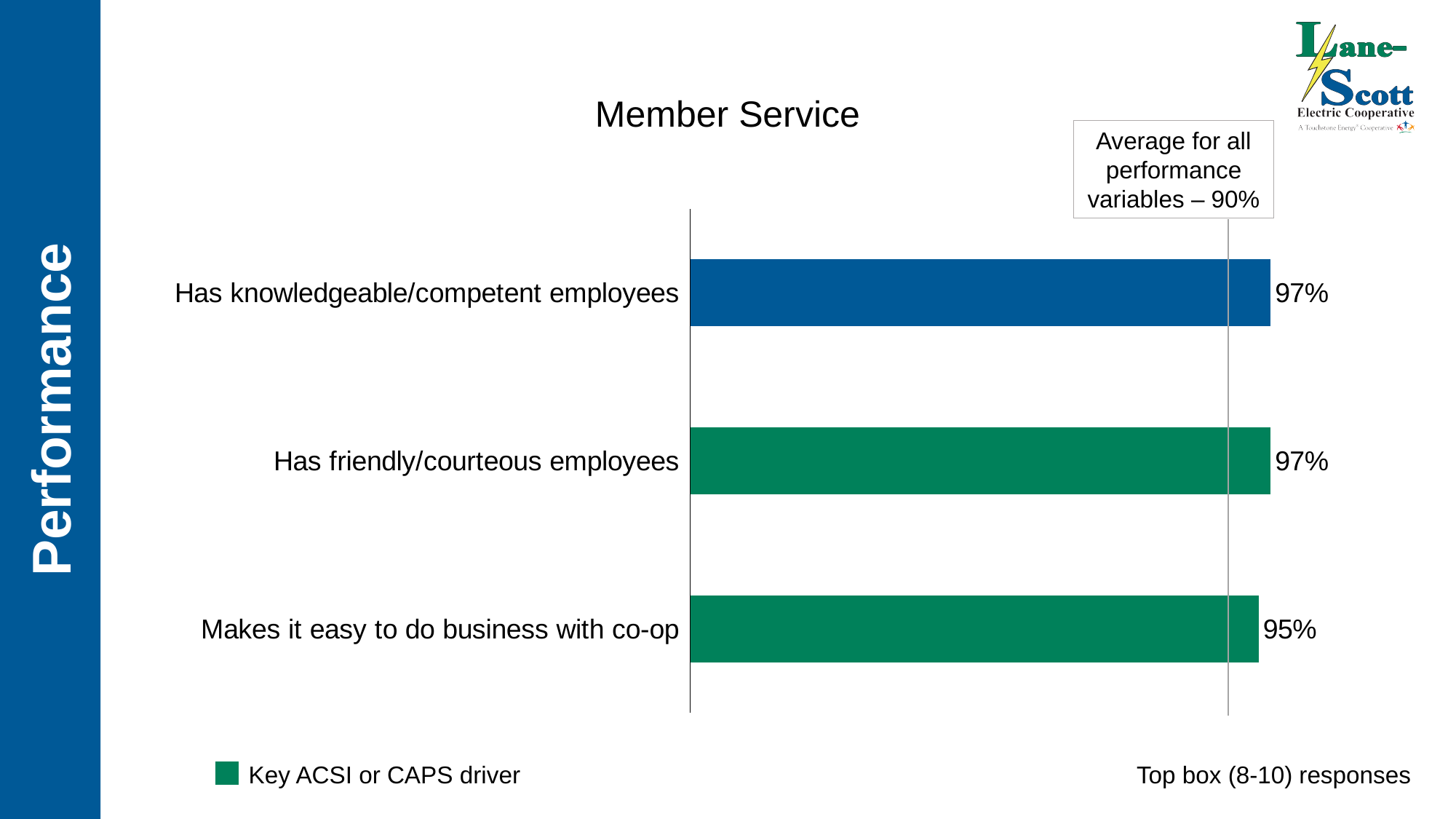
Which category has the lowest value? Makes it easy to do business with co-op Which is larger: the value for "Has knowledgeable/competent employees" or the value for "Makes it easy to do business with co-op"? Has knowledgeable/competent employees What kind of chart is shown on the slide? Bar chart How many categories are shown in the chart? 3 Is the value for "Makes it easy to do business with co-op" greater or less than the 90% average line? greater What is the value for "Has friendly/courteous employees"? 97% What is the average for all performance variables shown by the vertical reference line? 90% What is the value for "Makes it easy to do business with co-op"? 95% What is the title of the chart? Member Service What is the value for "Has knowledgeable/competent employees"? 97% What is the difference between the value for "Has friendly/courteous employees" and the value for "Makes it easy to do business with co-op"? 2%